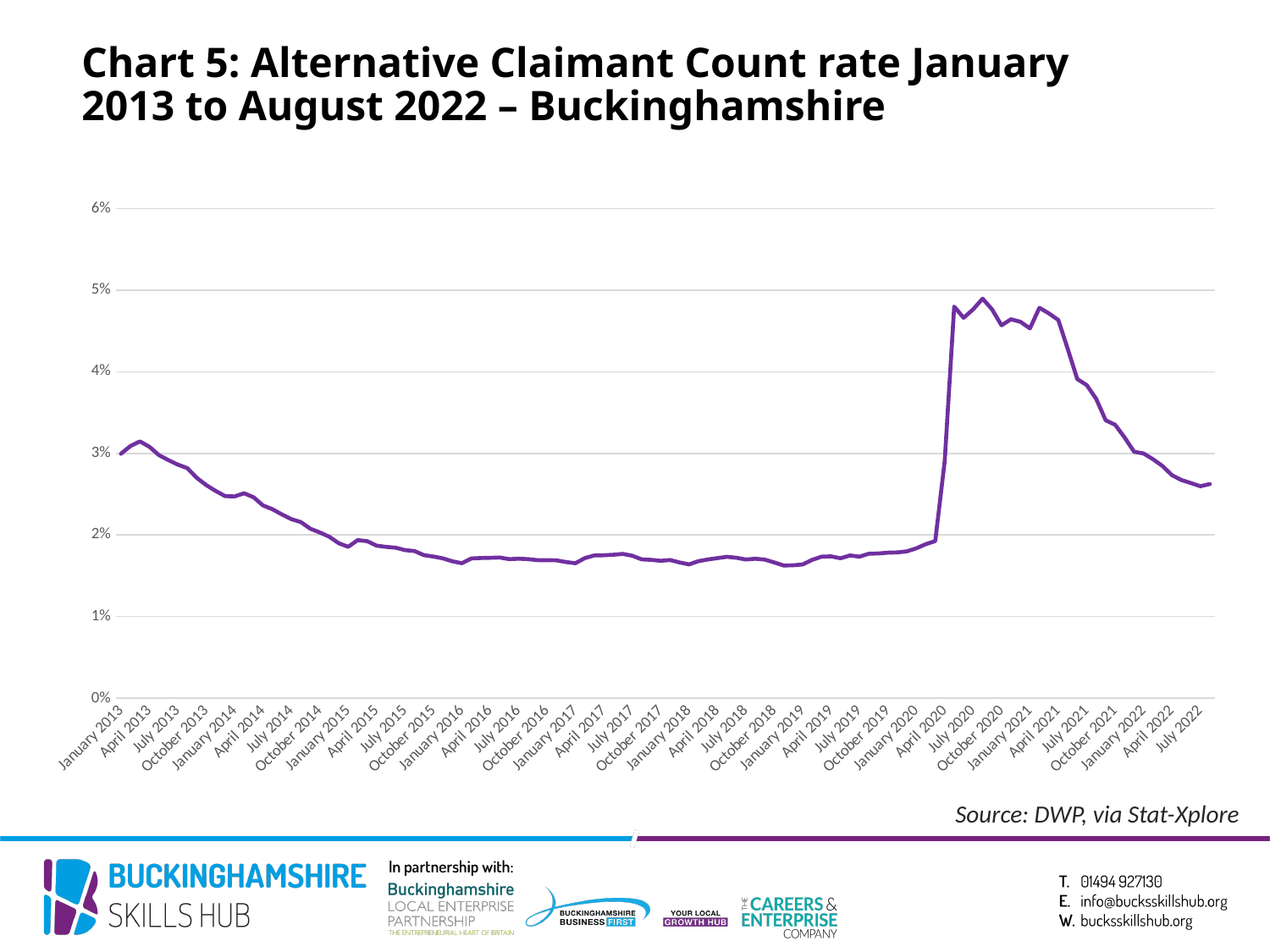
Which is larger, the value for July 2020 or the value for January 2013? July 2020 Is the value for July 2020 greater or less than 4%? greater In which year does the line reach its highest point? 2020 Is the value for April 2020 greater or less than 2%? greater Does the claimant count rate rise or fall between July 2021 and July 2022? fall What source is cited for the chart? DWP, via Stat-Xplore Is the value for October 2021 greater or less than 3%? greater What kind of chart is shown on the slide? line chart What is the title of the chart? Chart 5: Alternative Claimant Count rate January 2013 to August 2022 – Buckinghamshire Does the claimant count rate rise or fall between January 2013 and January 2016? fall